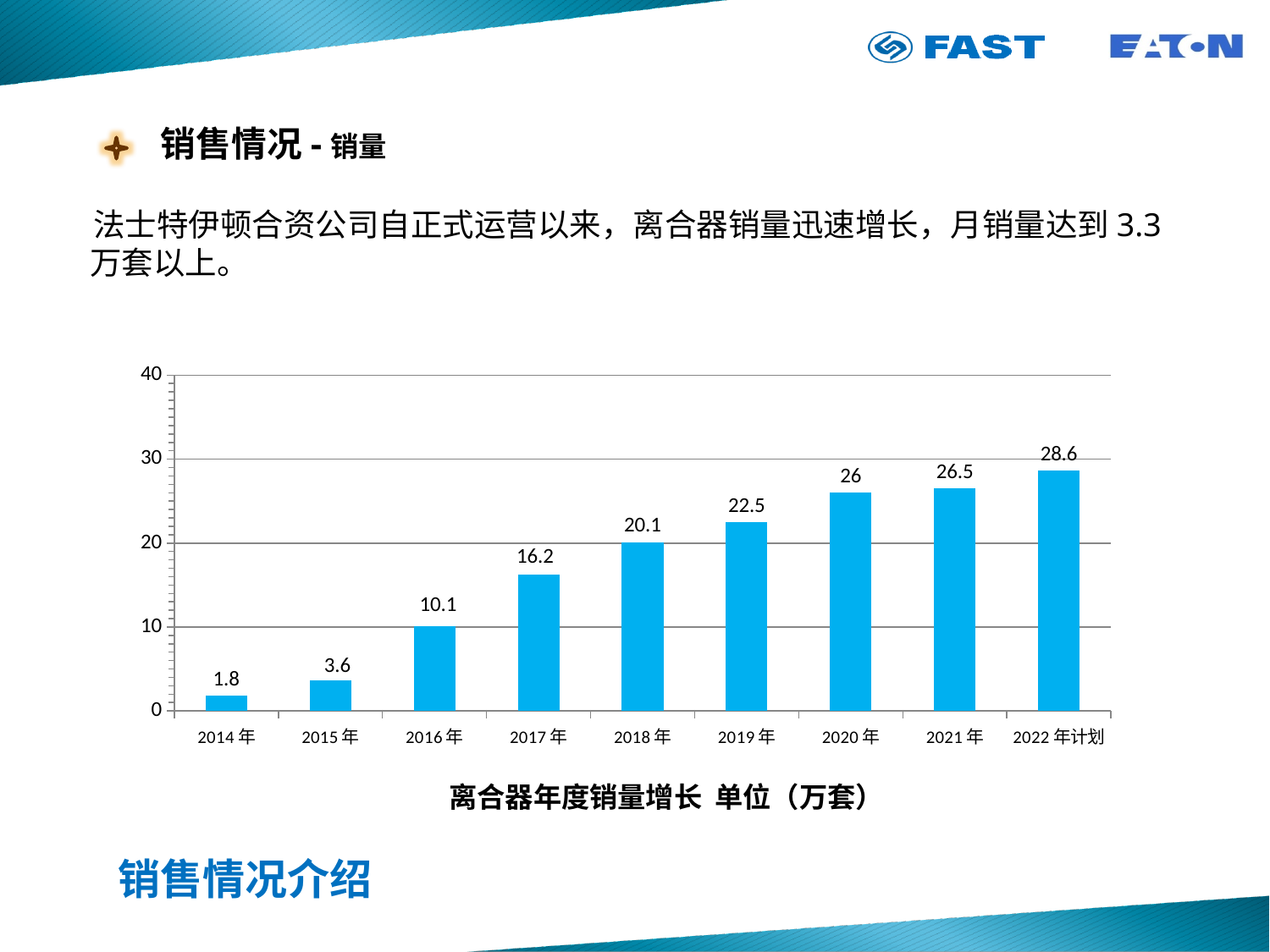
How many categories are shown on the x axis? 9 Which is larger, the value for 2018年 or the value for 2019年? 2019年 What kind of chart is shown on the slide? bar chart Which category has the highest value? 2022年计划 Which category has the lowest value? 2014年 What is the difference between the values for 2021年 and 2020年? 0.5 Is the value for 2019年 greater or less than 20? greater Do the values rise or fall from 2014年 to 2022年计划? rise What is the value for 2020年? 26 What is the difference between the values for 2016年 and 2015年? 6.5 What is the value for 2017年? 16.2 What is the value for 2022年计划? 28.6